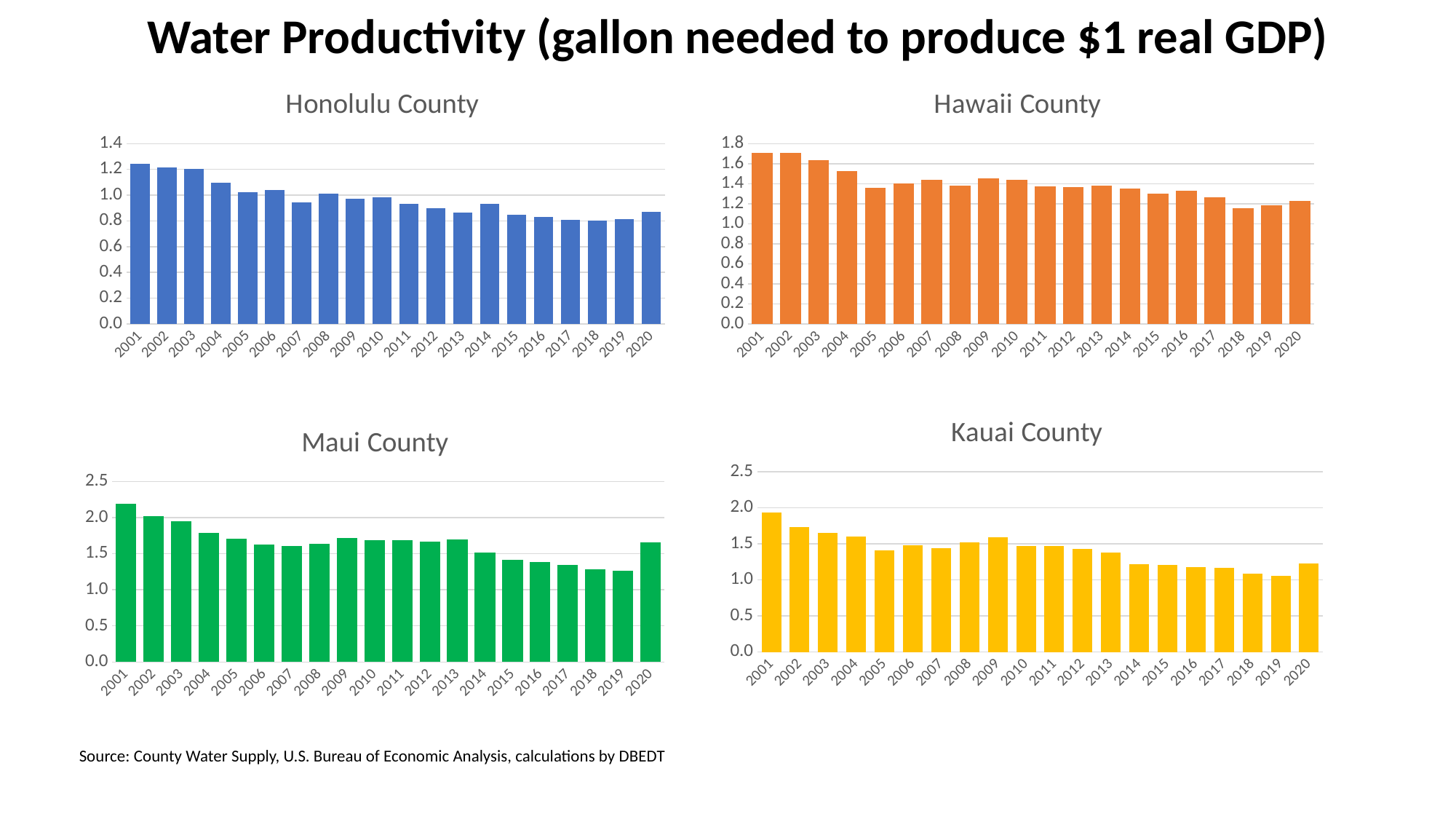
How many years are plotted in the Hawaii County chart? 20 In the Hawaii County chart, is the value for 2001 greater or less than 1.6? greater In the Kauai County chart, is the value for 2020 greater or less than 1.0? greater What is the title of the slide? Water Productivity (gallon needed to produce $1 real GDP) In the Kauai County chart, which is larger, the value for 2009 or the value for 2013? 2009 In the Maui County chart, is the value for 2020 greater or less than 1.5? greater In the Kauai County chart, which year has the highest value? 2001 In the Honolulu County chart, which year has the highest value? 2001 In the Honolulu County chart, do the values generally rise or fall from 2001 to 2020? fall What kind of chart is used for Honolulu County? bar chart In the Maui County chart, which year has the highest value? 2001